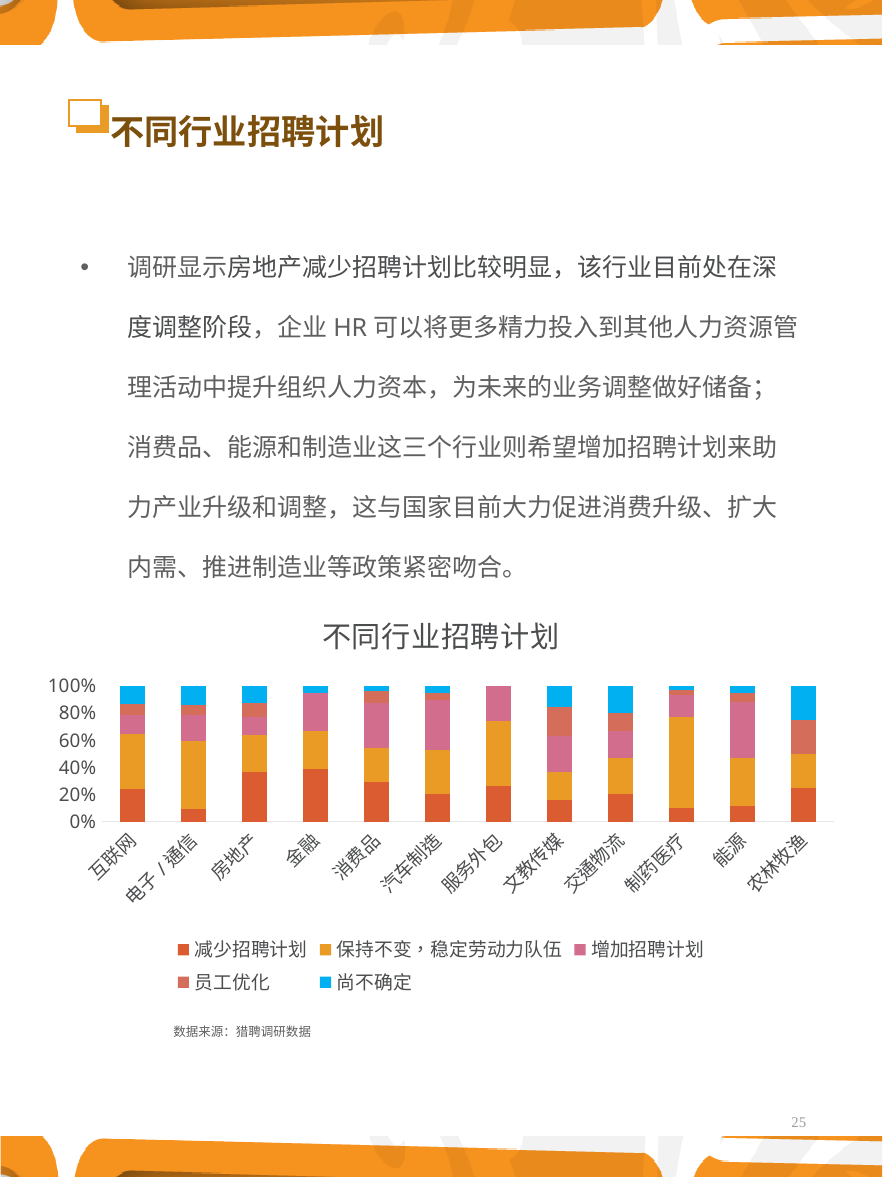
Is the 减少招聘计划 share for 制药医疗 greater or less than 20%? less Is the 减少招聘计划 share for 金融 greater or less than 20%? greater What is the total of each stacked bar in the chart? 100% Is the 减少招聘计划 share for 房地产 greater or less than 20%? greater What kind of chart is shown on the slide? stacked bar chart What is the data source stated below the chart? 猎聘调研数据 Which has a larger 减少招聘计划 share, 金融 or 互联网? 金融 What is the title of the chart? 不同行业招聘计划 How many series does the chart legend list? 5 How many industries (categories) are shown on the x axis of the chart? 12 Which has a larger 减少招聘计划 share, 房地产 or 电子/通信? 房地产